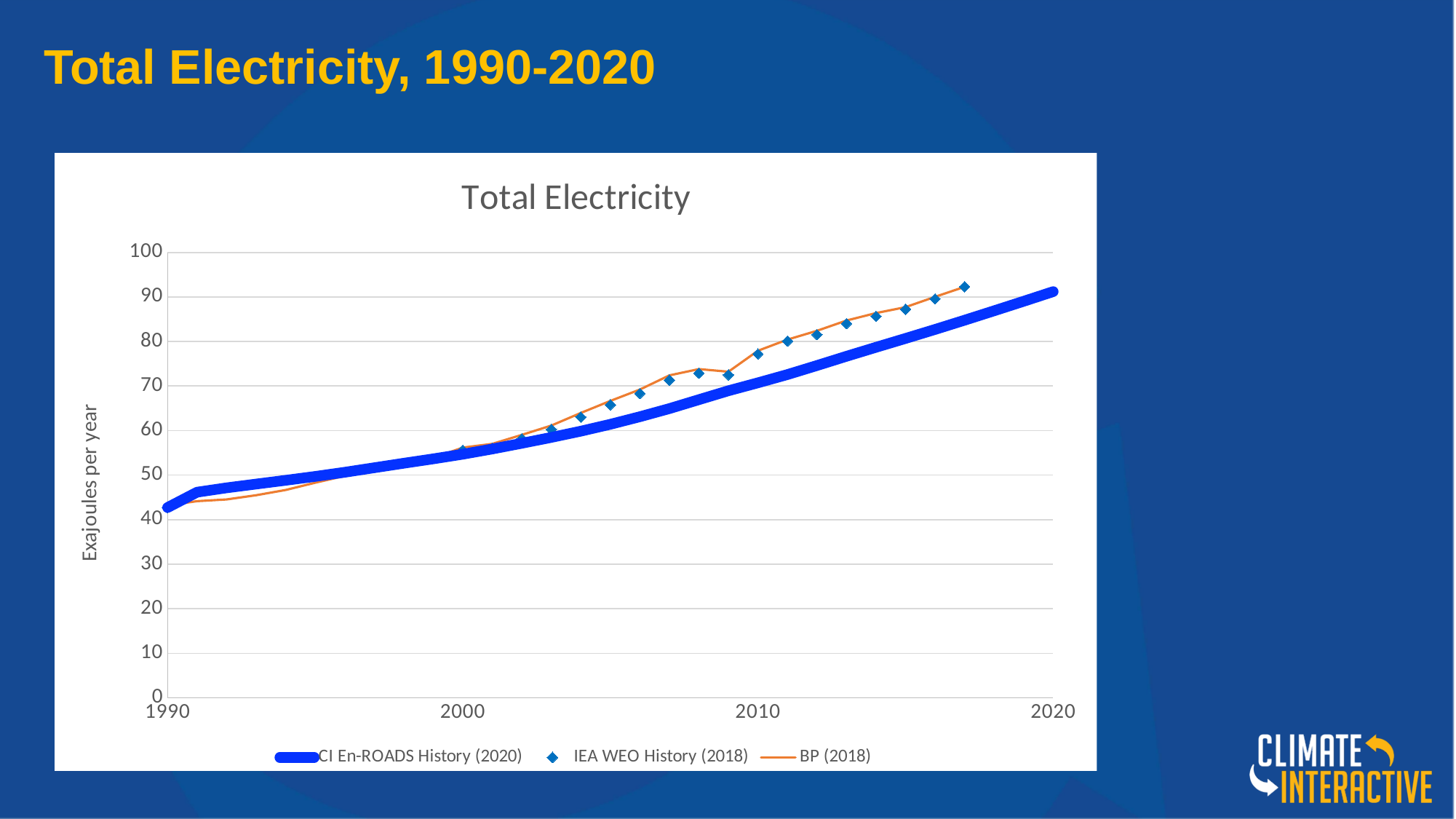
How many series does the legend list? 3 What kind of chart is shown on the slide? line chart Is the value for CI En-ROADS History (2020) in 2010 greater or less than 60? greater Do the values for BP (2018) rise or fall overall along the x axis? rise Is the value for IEA WEO History (2018) in 2010 greater or less than 70? greater Is the value for BP (2018) in 2000 greater or less than 60? less In 2015, which series has the higher value, IEA WEO History (2018) or CI En-ROADS History (2020)? IEA WEO History (2018) Do the values for CI En-ROADS History (2020) rise or fall from 1990 to 2020? rise What is the title of the chart? Total Electricity What is the label on the vertical axis? Exajoules per year